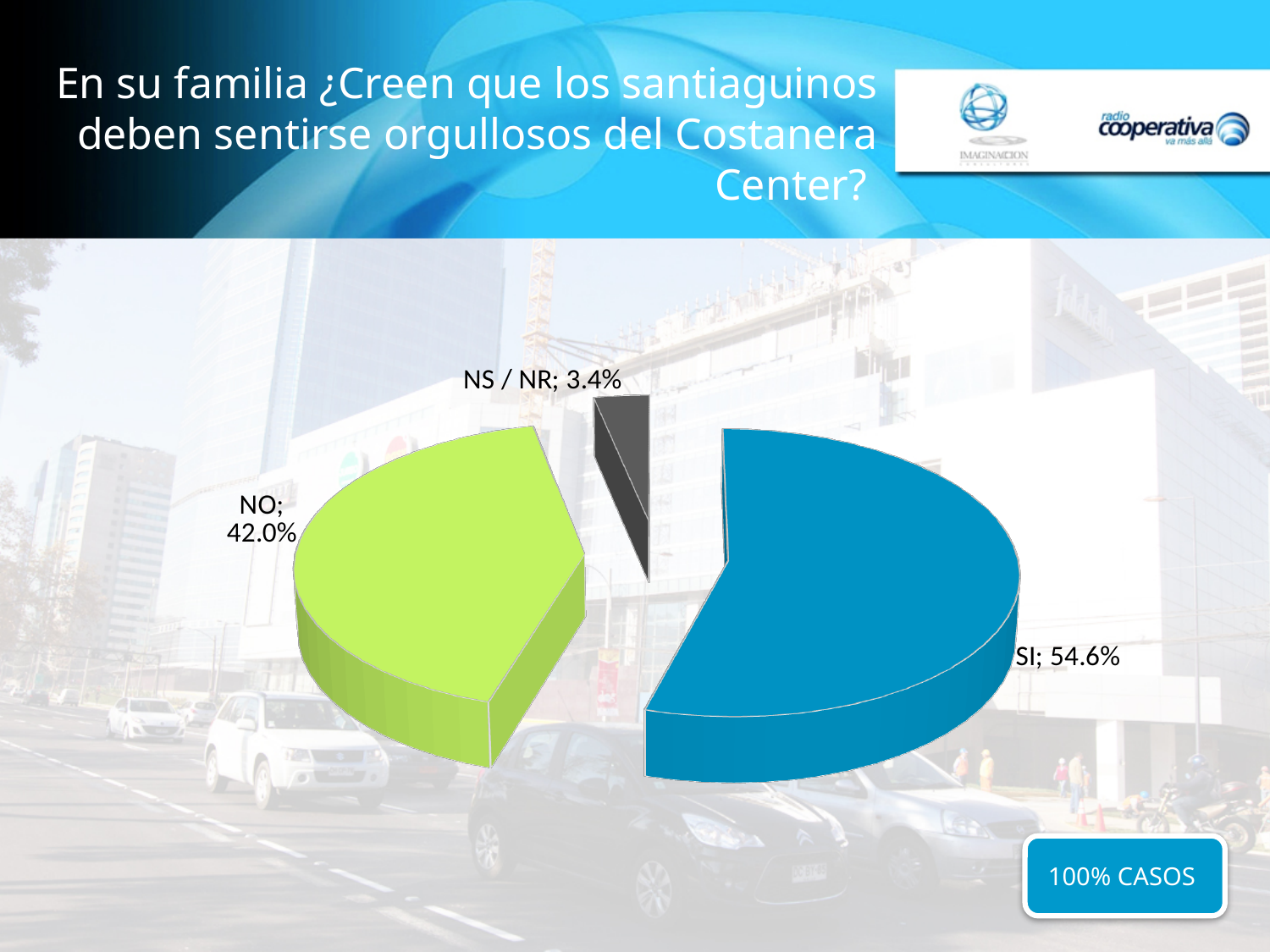
What is the combined share of NO and NS / NR? 45.4% Which is larger, the share for SI or the share for NO? SI What percentage of respondents answered SI? 54.6% How many slices does the pie chart have? 3 Which response has the smallest share of the pie? NS / NR What text appears in the box at the bottom right of the slide? 100% CASOS What percentage is shown for NS / NR? 3.4% Which response has the largest share of the pie? SI What colour is the SI slice? Blue What is the difference in percentage points between SI and NO? 12.6 What percentage of respondents answered NO? 42.0% What kind of chart is shown on the slide? Pie chart